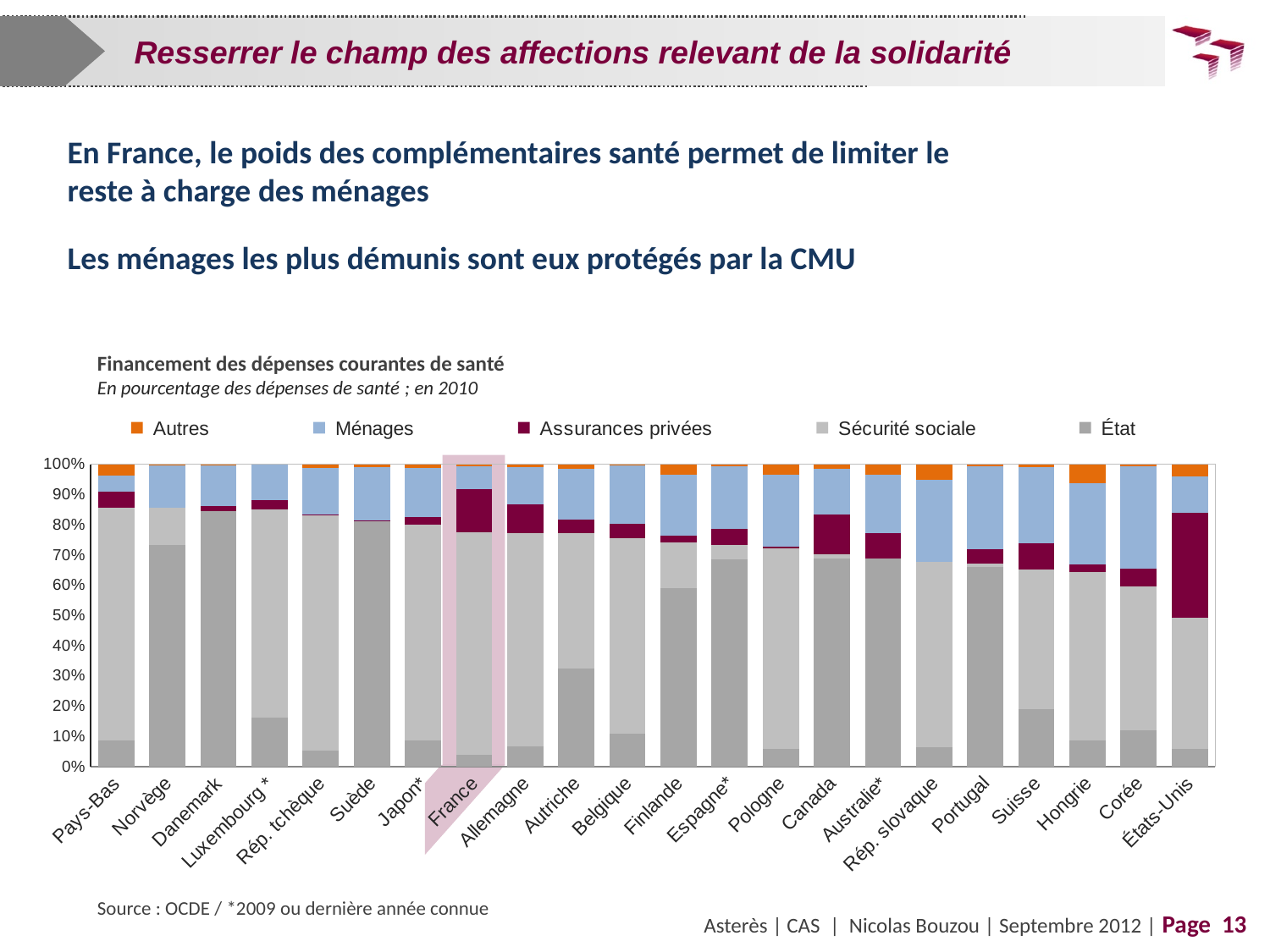
Is the État share for Pays-Bas greater or less than 10%? less What type of chart is shown on the slide? Stacked bar chart Is the État share for Finlande greater or less than 50%? greater Is the État share for Suède greater or less than 70%? greater Which country has the larger Ménages share, Suisse or Danemark? Suisse Which country is highlighted with a shaded band on the chart? France Which country has the larger État share, Suède or Pays-Bas? Suède How many series does the chart legend list? 5 How many countries are shown on the x axis of the chart? 22 Which country has the largest share of Assurances privées? États-Unis What is the title of the chart? Financement des dépenses courantes de santé